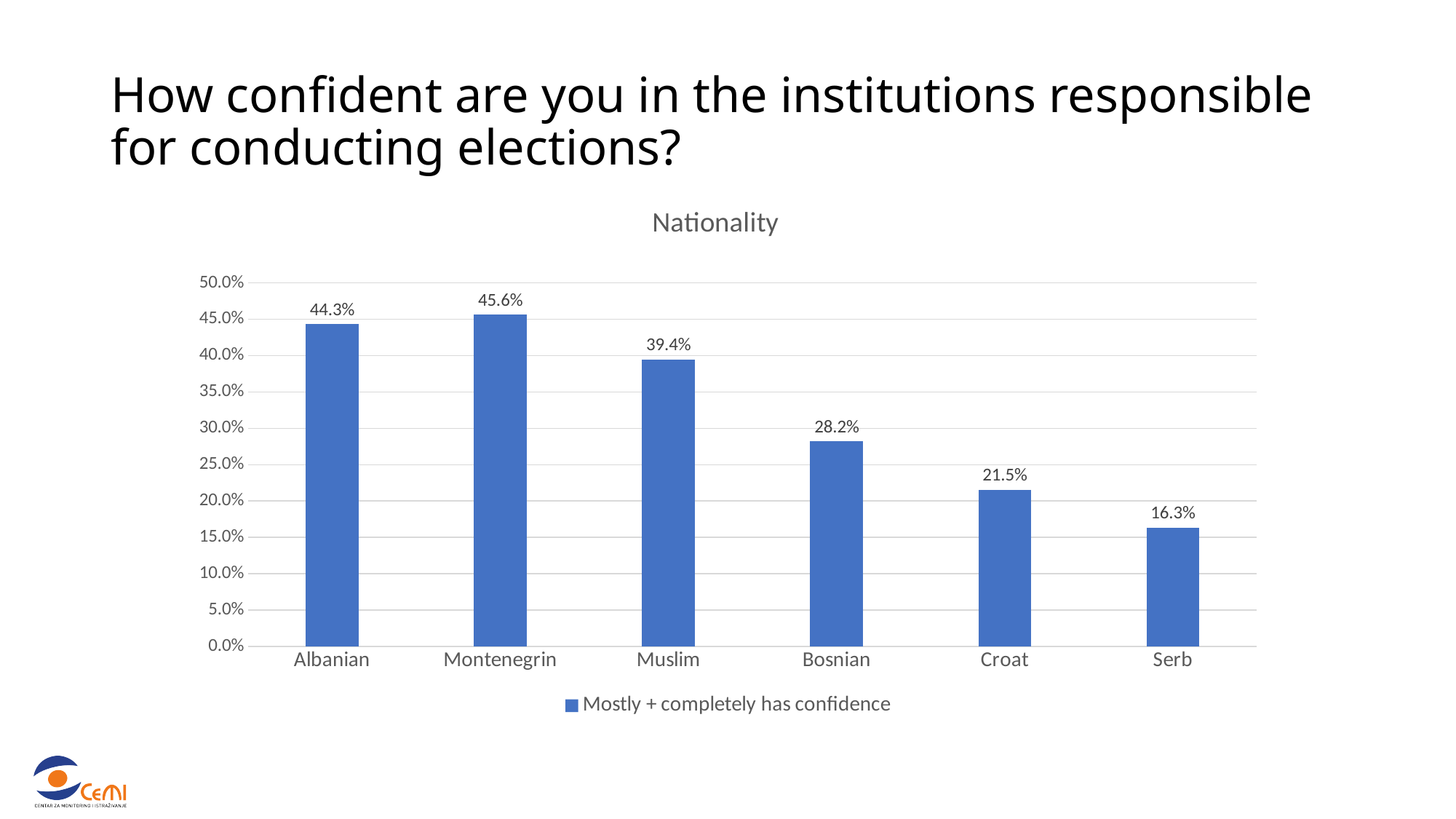
How many series does the legend list? 1 Which is larger, the value for Bosnian or the value for Croat? Bosnian Which nationality has the highest value? Montenegrin What is the difference between the values for Muslim and Croat? 17.9% How many nationalities are shown on the x axis? 6 What kind of chart is shown? bar chart What is the value for Serb? 16.3% What is the value for Albanian? 44.3% Is the value for Muslim greater or less than 35.0%? greater Which nationality has the lowest value? Serb What is the value for Bosnian? 28.2% What is the title of the chart? Nationality